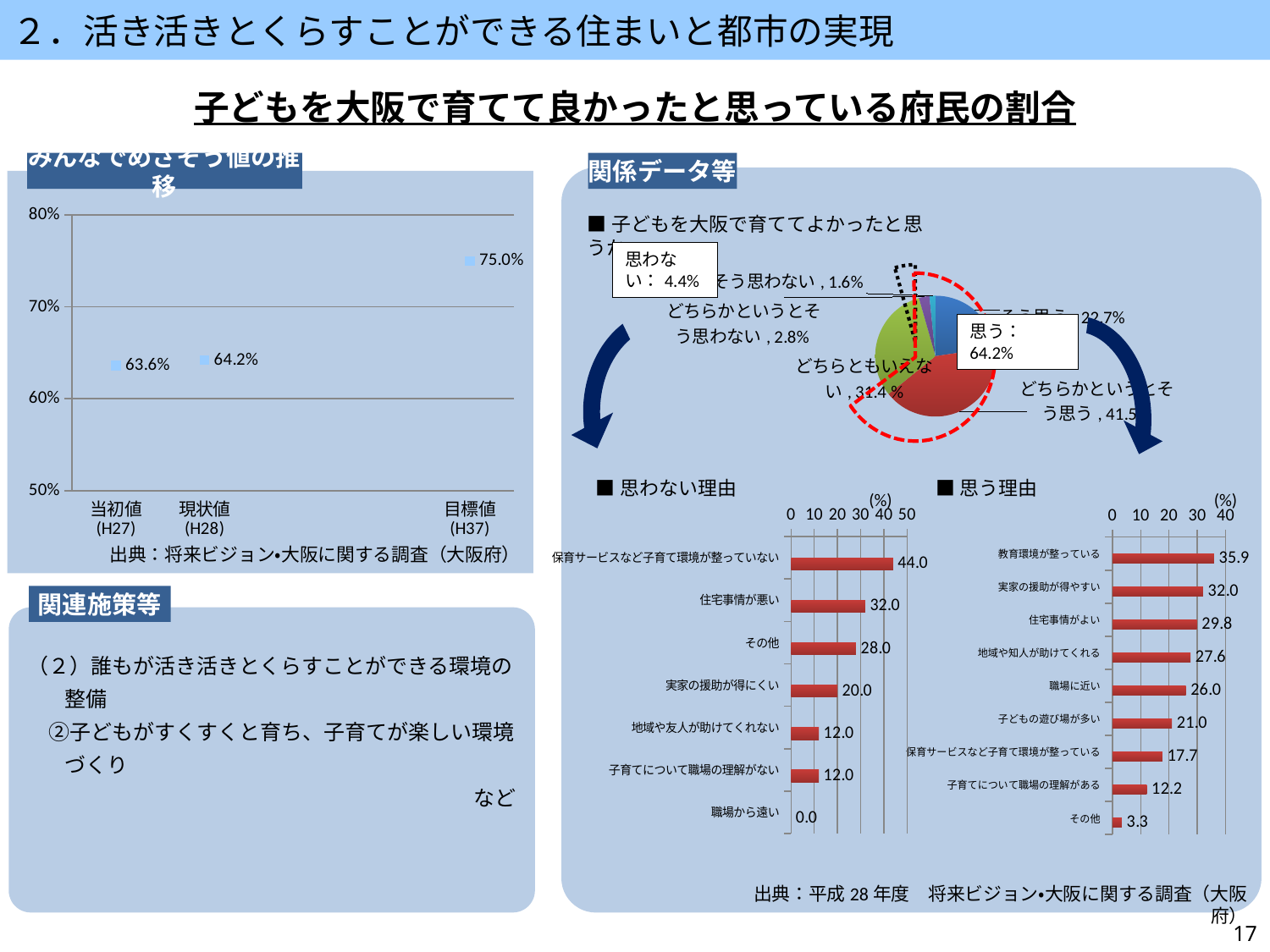
In the bar chart titled 思わない理由, which category has the highest value? 保育サービスなど子育て環境が整っていない In the pie chart titled 子どもを大阪で育ててよかったと思うか, what is the share for どちらともいえない? 31.4% In the chart titled みんなでめざそう値の推移, what is the value for 目標値 (H37)? 75.0% In the pie chart titled 子どもを大阪で育ててよかったと思うか, which slice is the largest? どちらかというとそう思う In the bar chart titled 思う理由, which category has the lowest value? その他 In the bar chart titled 思う理由, what is the value for 教育環境が整っている? 35.9 In the bar chart titled 思わない理由, how many categories are shown? 7 In the pie chart titled 子どもを大阪で育ててよかったと思うか, what is the share for そう思わない? 1.6% In the chart titled みんなでめざそう値の推移, what is the value for 当初値 (H27)? 63.6% In the bar chart titled 思わない理由, what is the value for 住宅事情が悪い? 32.0 In the chart titled みんなでめざそう値の推移, do the values rise or fall from 当初値 (H27) to 目標値 (H37)? rise In the chart titled みんなでめざそう値の推移, what is the difference between the 目標値 (H37) and the 現状値 (H28)? 10.8%